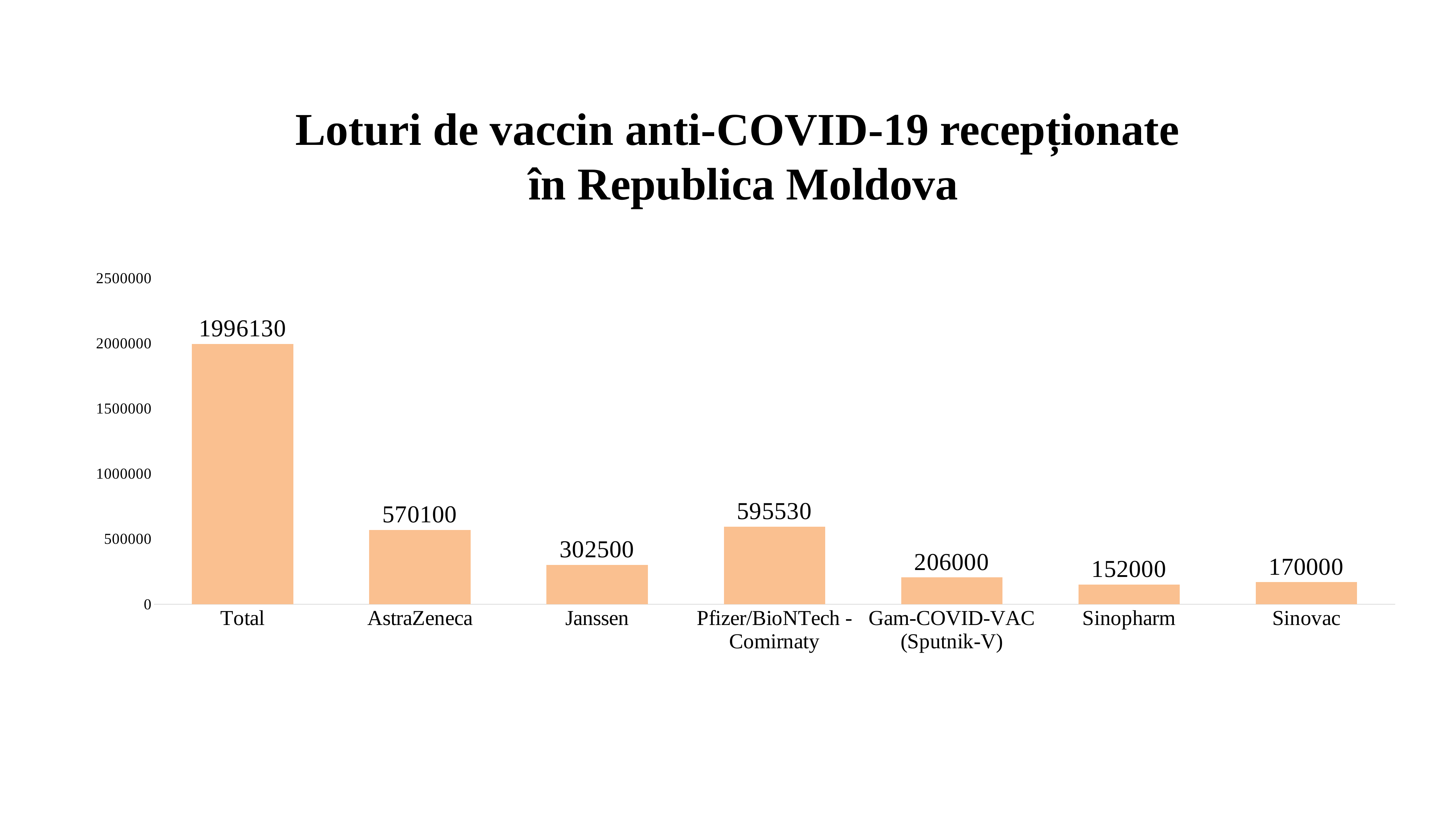
What is the difference between the values for Pfizer/BioNTech - Comirnaty and AstraZeneca? 25430 Which is larger, the value for Janssen or the value for Gam-COVID-VAC (Sputnik-V)? Janssen Which category has the lowest value? Sinopharm How many bars are shown in the chart? 7 What is the value for Sinopharm? 152000 What is the difference between the values for Sinovac and Sinopharm? 18000 Excluding the Total bar, which vaccine has the highest value? Pfizer/BioNTech - Comirnaty What kind of chart is shown on the slide? Bar chart What is the value for AstraZeneca? 570100 What is the value for Gam-COVID-VAC (Sputnik-V)? 206000 What is the title of the chart? Loturi de vaccin anti-COVID-19 recepționate în Republica Moldova What is the value for Janssen? 302500